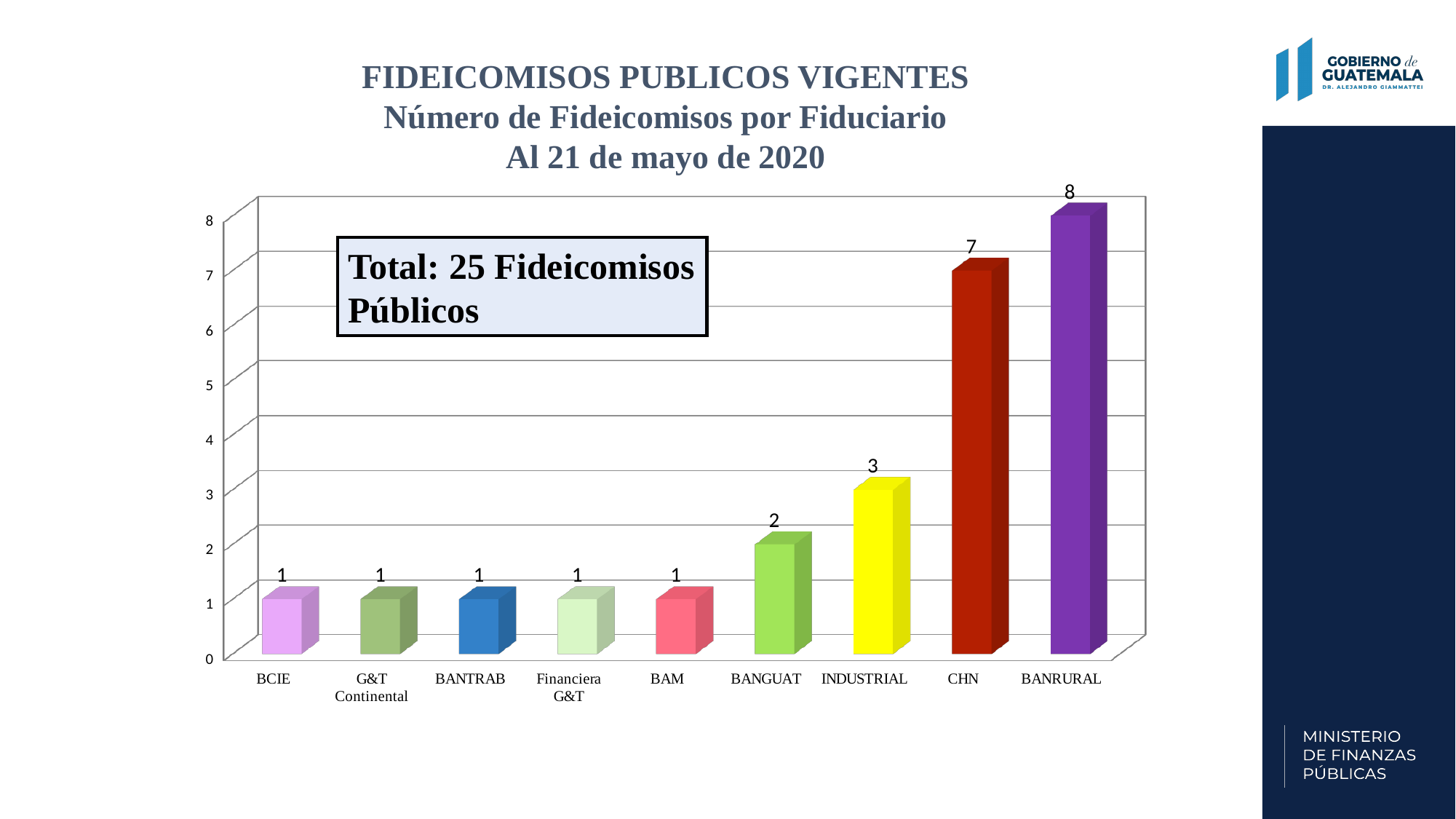
What is the difference between the values for CHN and INDUSTRIAL? 4 What total number of fideicomisos públicos is stated in the box on the chart? 25 What is the difference between the values for BANRURAL and CHN? 1 What is the number of fideicomisos for INDUSTRIAL? 3 What kind of chart is shown on the slide? Bar chart What is the number of fideicomisos for BANTRAB? 1 Which fiduciario has the highest number of fideicomisos? BANRURAL What is the number of fideicomisos for BANGUAT? 2 What is the number of fideicomisos for BANRURAL? 8 Which has a larger value, BANGUAT or INDUSTRIAL? INDUSTRIAL What is the number of fideicomisos for CHN? 7 How many fiduciarios are shown on the x axis? 9